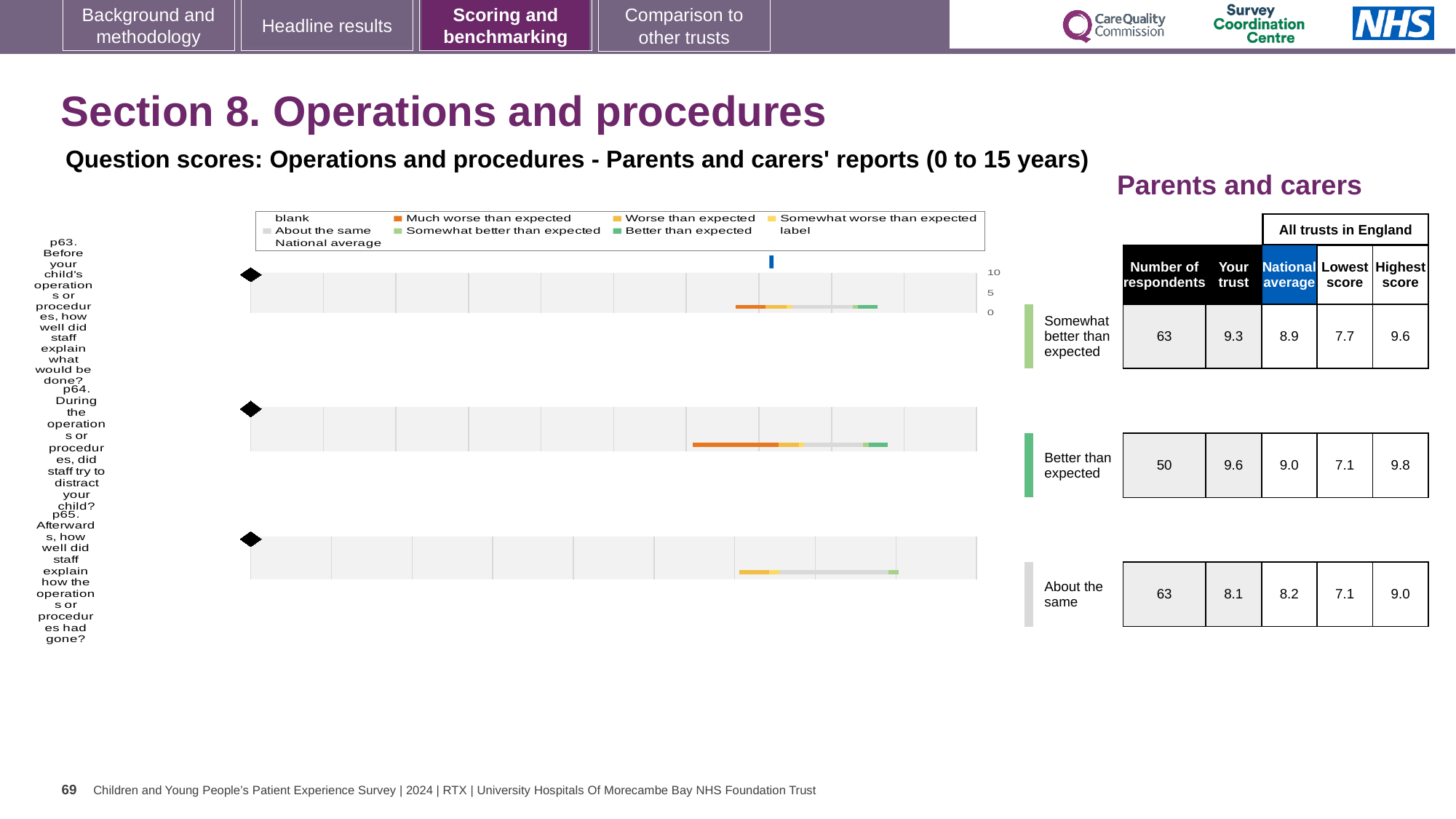
What is the difference between the trust score and the national average for p64? 0.6 For p63, is the trust score higher or lower than the national average? higher What is the 'Your trust' score for p64 (During the operations or procedures, did staff try to distract your child?)? 9.6 What is the highest score across all trusts in England for p63? 9.6 How many respondents answered p64? 50 What is the national average for p63 (Before your child's operations or procedures, how well did staff explain what would be done?)? 8.9 Which benchmark category is p65 (Afterwards, how well did staff explain how the operations or procedures had gone?) placed in? About the same What kind of chart is used to show the question scores for Operations and procedures? bar chart Which question has the lowest 'Your trust' score? p65 How many questions (p63, p64, p65) are plotted in the chart? 3 What colour does the legend use for 'Much worse than expected'? orange Which question has the highest 'Your trust' score? p64